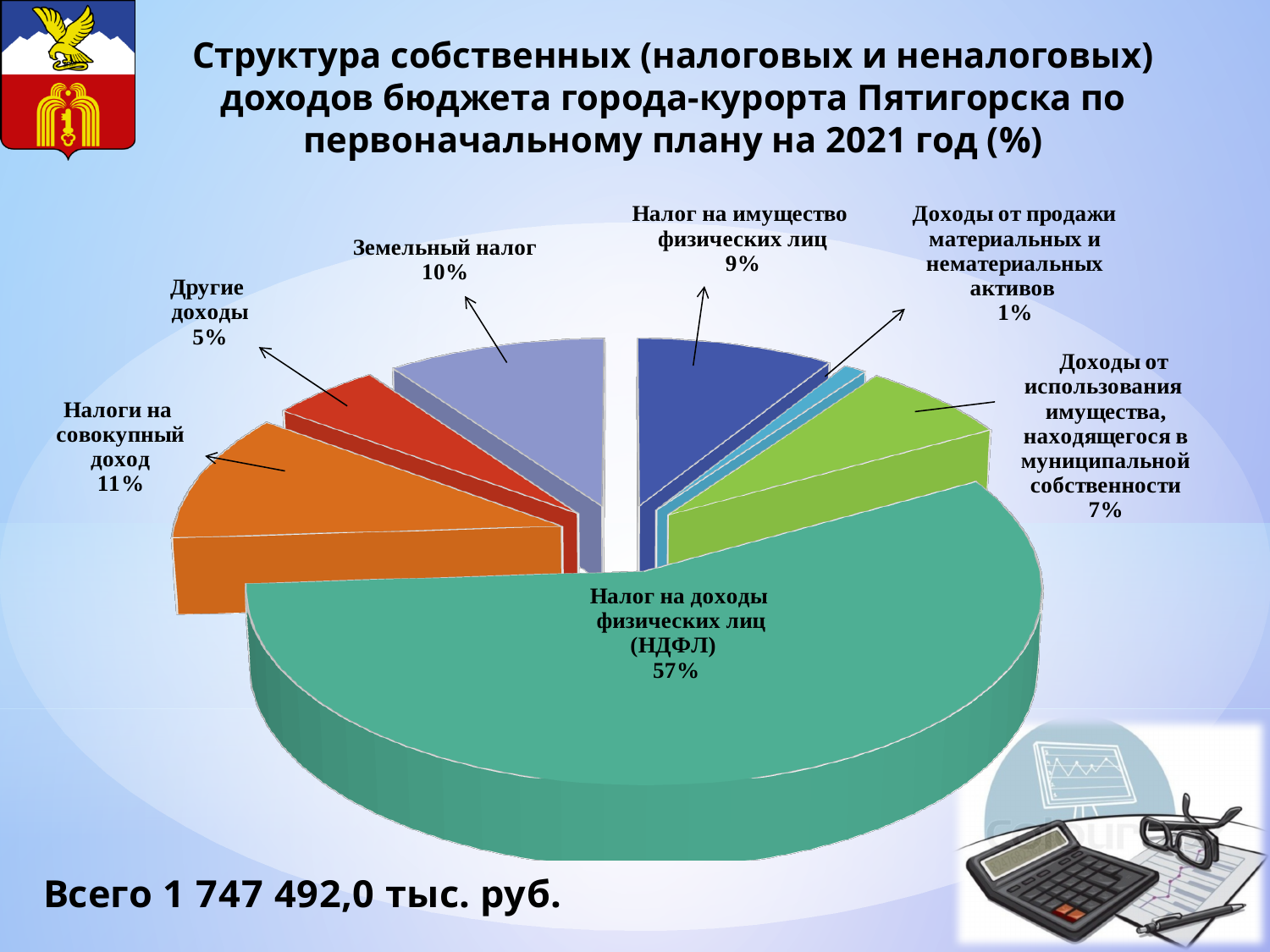
What percentage is shown for "Доходы от использования имущества, находящегося в муниципальной собственности"? 7% What total amount of own revenues is stated below the chart? 1 747 492,0 тыс. руб. Which is larger: the share for "Земельный налог" or the share for "Налог на имущество физических лиц"? Земельный налог Which category has the smallest share of the pie? Доходы от продажи материальных и нематериальных активов What kind of chart is shown on the slide? pie chart What percentage is shown for "Земельный налог"? 10% Which category has the largest share of the pie? Налог на доходы физических лиц (НДФЛ) What share of the budget's own revenues does "Налог на доходы физических лиц (НДФЛ)" account for? 57% What percentage is shown for "Доходы от продажи материальных и нематериальных активов"? 1% What is the difference in percentage points between "Налоги на совокупный доход" and "Другие доходы"? 6 How many categories (slices) does the pie chart have? 7 What percentage is shown for "Налоги на совокупный доход"? 11%